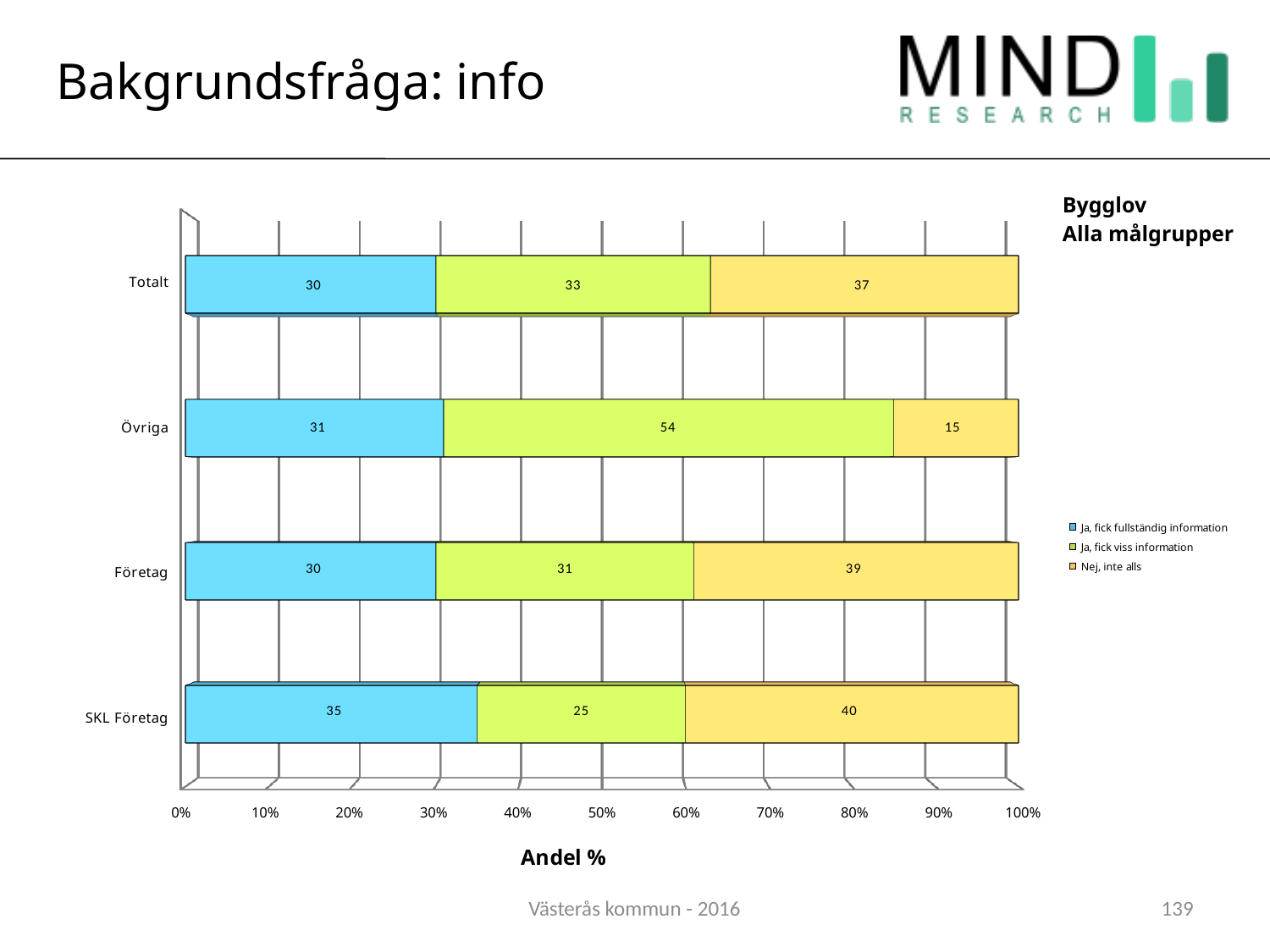
What is the difference between the 'Nej, inte alls' values for SKL Företag and Övriga? 25 What is the label of the x axis? Andel % What is the value for 'Ja, fick viss information' in the Övriga bar? 54 What is the value for 'Ja, fick fullständig information' in the SKL Företag bar? 35 What kind of chart is shown on the slide? Stacked bar chart Which category has the highest value for 'Ja, fick viss information'? Övriga How many categories are shown on the y axis? 4 What is the value for 'Ja, fick fullständig information' in the Totalt bar? 30 How many series does the legend list? 3 Which is larger: the 'Ja, fick viss information' value for Totalt or for SKL Företag? Totalt Which category has the lowest value for 'Nej, inte alls'? Övriga What is the value for 'Nej, inte alls' in the Företag bar? 39